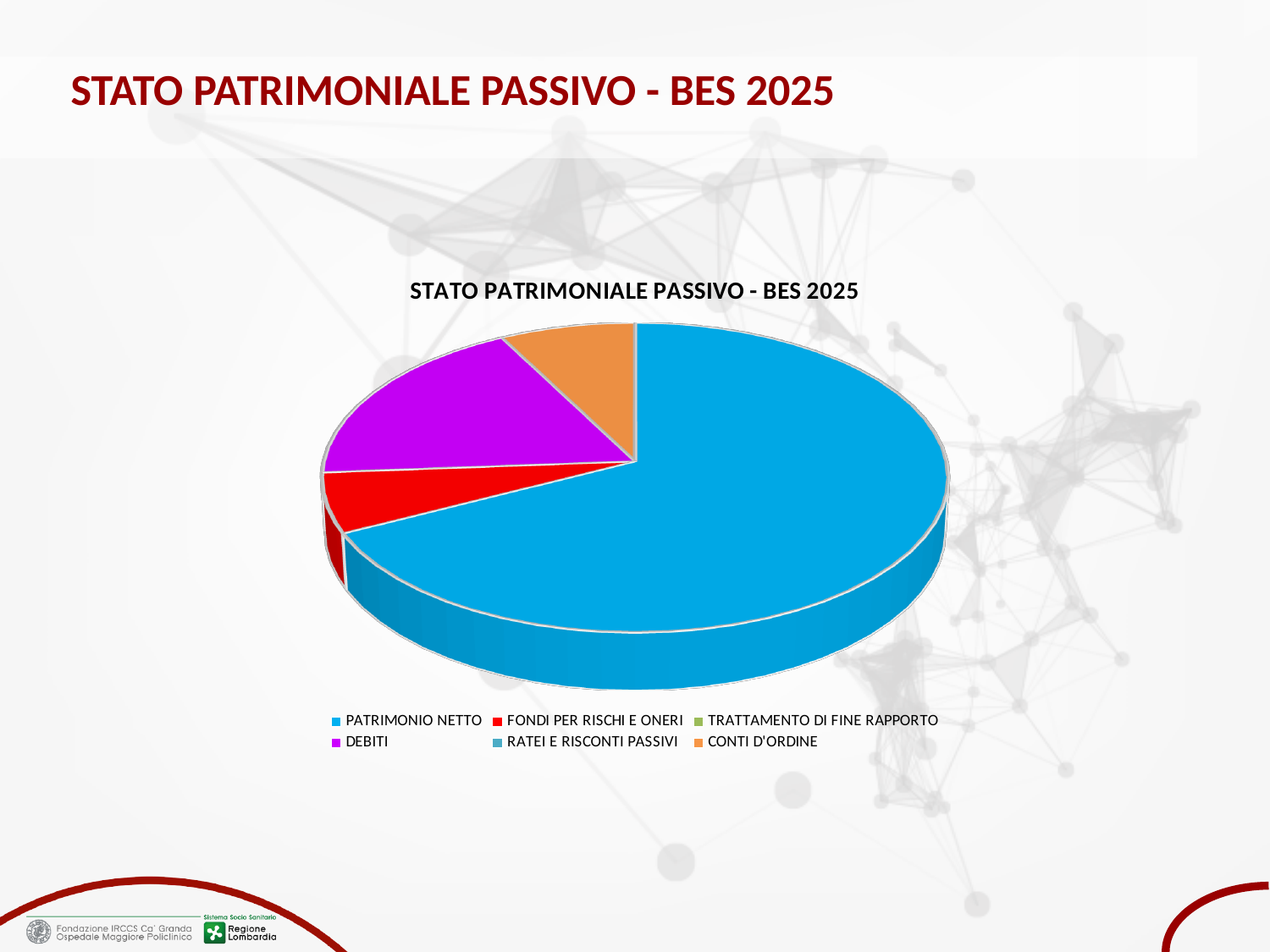
Which colour represents DEBITI in the chart? Purple Which category has the largest slice of the pie? PATRIMONIO NETTO Does the PATRIMONIO NETTO slice take up more or less than half of the pie? More Which slice is larger, PATRIMONIO NETTO or CONTI D'ORDINE? PATRIMONIO NETTO How many categories does the chart's legend list? 6 Which slice is larger, DEBITI or CONTI D'ORDINE? DEBITI Which slice is larger, DEBITI or FONDI PER RISCHI E ONERI? DEBITI What is the title of the chart? STATO PATRIMONIALE PASSIVO - BES 2025 What kind of chart is shown on the slide? Pie chart